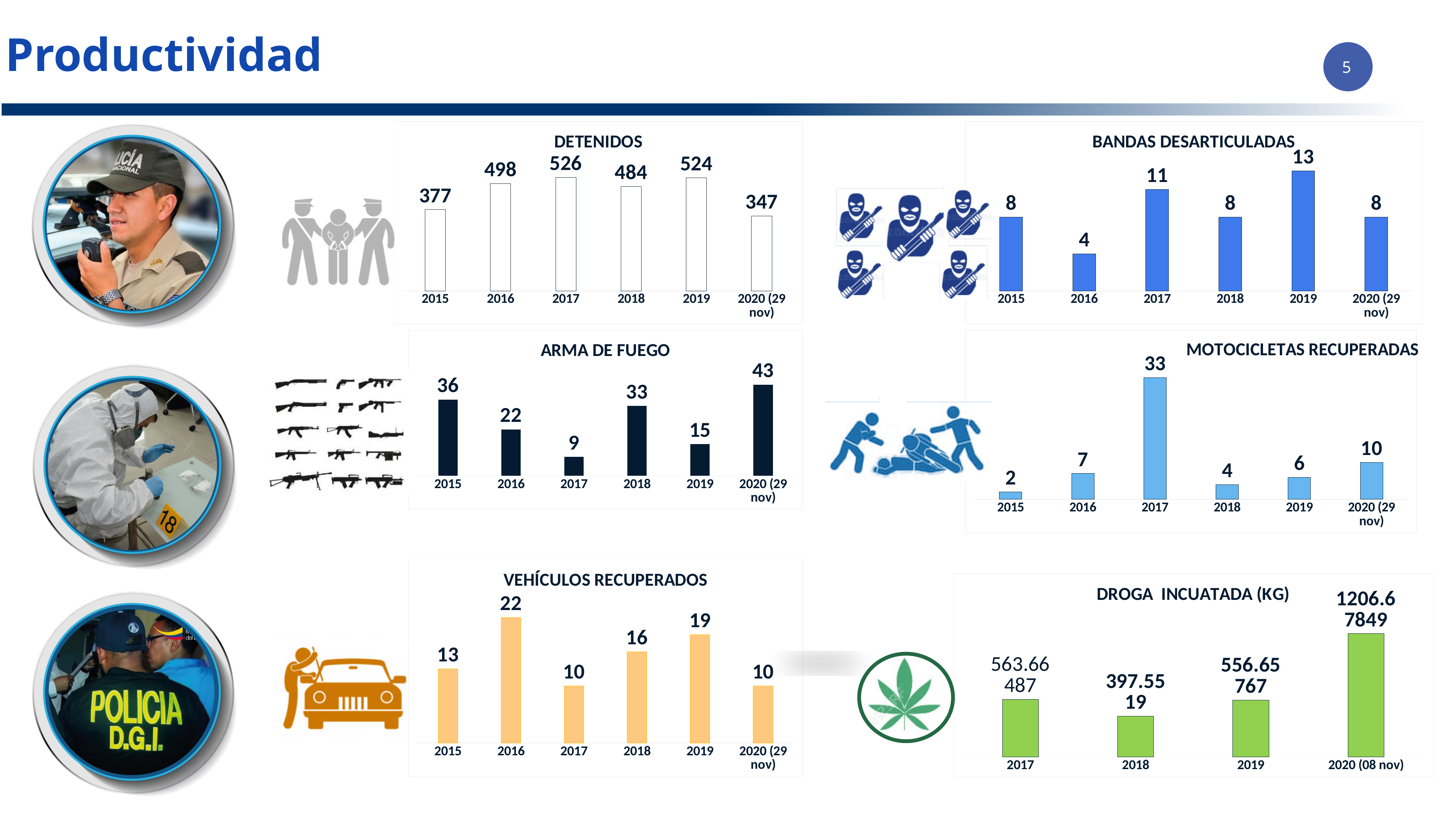
In the ARMA DE FUEGO chart, what is the value for 2020 (29 nov)? 43 In the BANDAS DESARTICULADAS chart, which year has the highest value? 2019 In the DETENIDOS chart, what is the difference between the values for 2016 and 2015? 121 In the DROGA INCUATADA (KG) chart, which year has the highest value? 2020 (08 nov) What type of chart is the VEHÍCULOS RECUPERADOS chart? Bar chart In the MOTOCICLETAS RECUPERADAS chart, which year has the highest value? 2017 In the BANDAS DESARTICULADAS chart, what is the value for 2016? 4 In the MOTOCICLETAS RECUPERADAS chart, how many years are shown on the x axis? 6 In the DETENIDOS chart, what is the value for 2017? 526 In the ARMA DE FUEGO chart, which is larger, the value for 2015 or the value for 2018? 2015 In the DETENIDOS chart, which year has the lowest value? 2020 (29 nov) In the VEHÍCULOS RECUPERADOS chart, what is the difference between the values for 2016 and 2017? 12